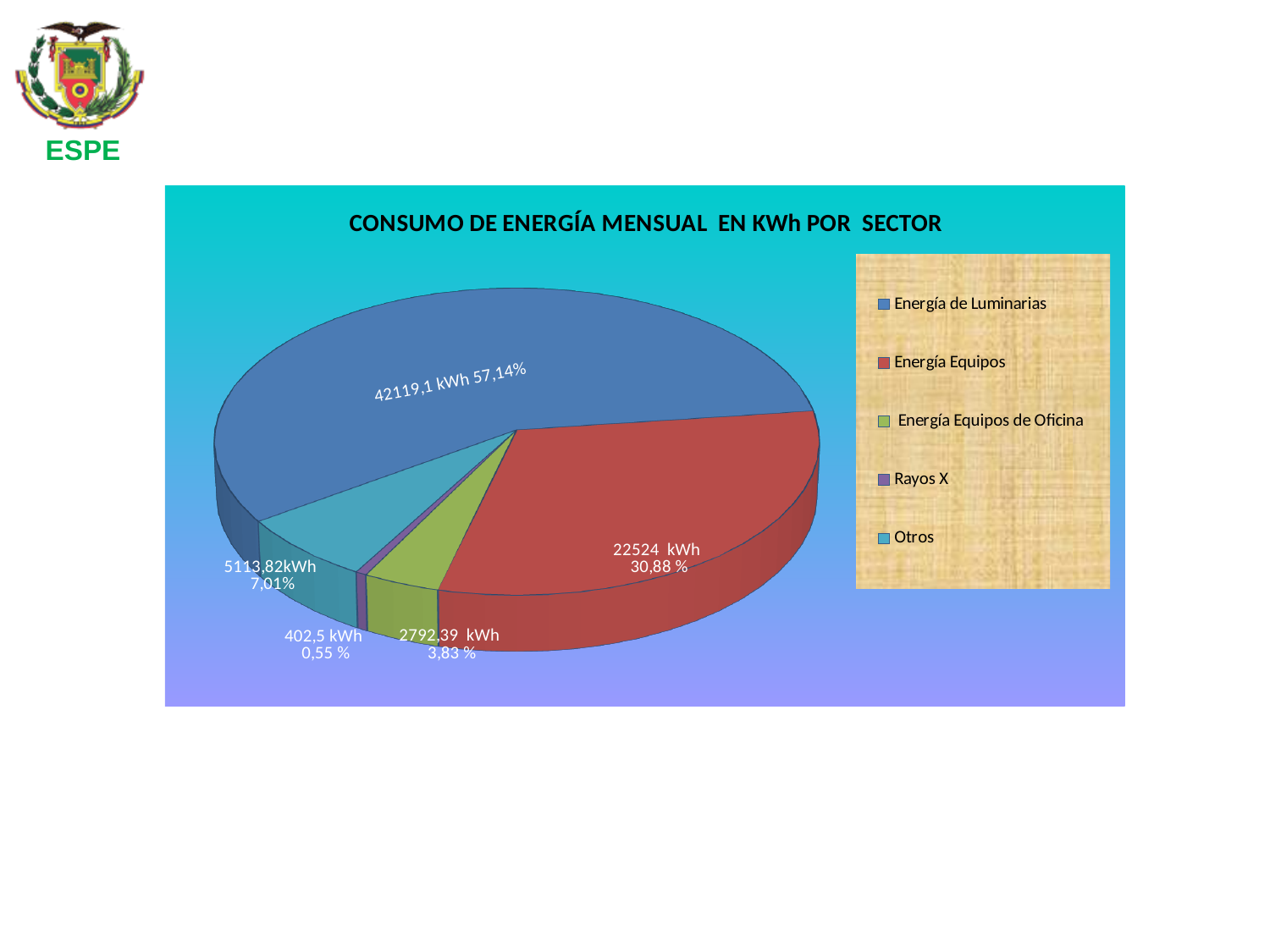
Which sector consumes more energy, Otros or Energía Equipos de Oficina? Otros What is the monthly energy consumption for Otros? 5113,82 kWh What share of the pie does Energía de Luminarias represent? 57,14% What kind of chart is shown on the slide? Pie chart Which sector has the largest energy consumption? Energía de Luminarias What is the monthly energy consumption for Energía de Luminarias? 42119,1 kWh What is the monthly energy consumption for Energía Equipos? 22524 kWh What is the title of the chart? CONSUMO DE ENERGÍA MENSUAL EN KWh POR SECTOR What is the monthly energy consumption for Rayos X? 402,5 kWh How many sectors does the legend list? 5 What share of the pie does Energía Equipos de Oficina represent? 3,83 % Which sector has the smallest energy consumption? Rayos X